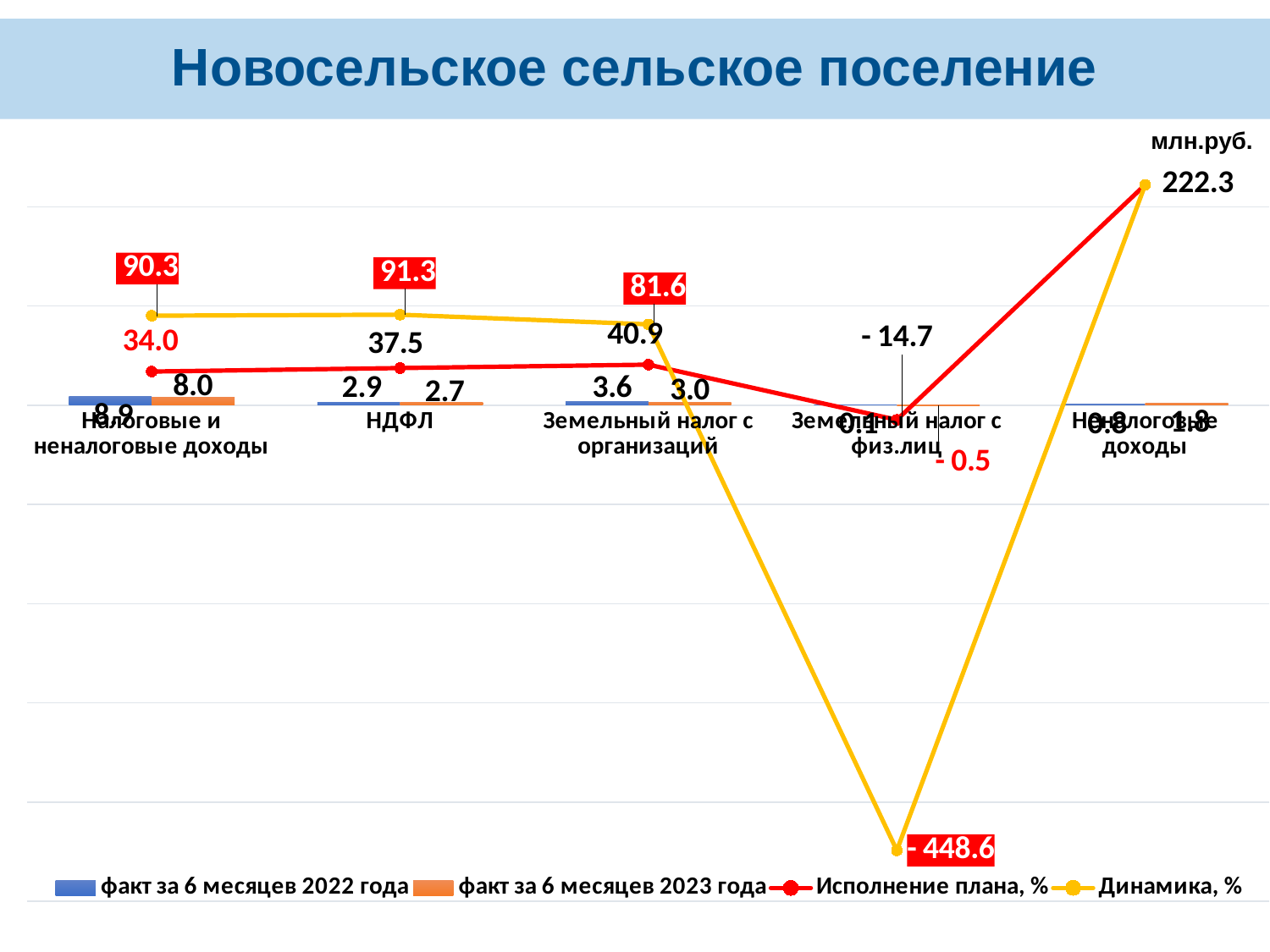
Which is larger for 'НДФЛ': the 2022 value or the 2023 value? 2022 value (2.9) How many categories are shown along the x axis? 5 What kind of chart is shown on the slide? Combined bar and line chart What is the 'Динамика, %' value for 'НДФЛ'? 91.3 Which category has the lowest 'Динамика, %' value? Земельный налог с физ.лиц What unit is indicated in the top right corner of the chart? млн.руб. What is the value of 'факт за 6 месяцев 2023 года' for 'Налоговые и неналоговые доходы'? 8.0 How many series does the legend list? 4 What is the 'Динамика, %' value for 'Земельный налог с физ.лиц'? - 448.6 What is the difference between the 2022 and 2023 values for 'Земельный налог с организаций'? 0.6 What is the value of 'факт за 6 месяцев 2023 года' for 'НДФЛ'? 2.7 What is the value of 'факт за 6 месяцев 2022 года' for 'Налоговые и неналоговые доходы'? 8.9